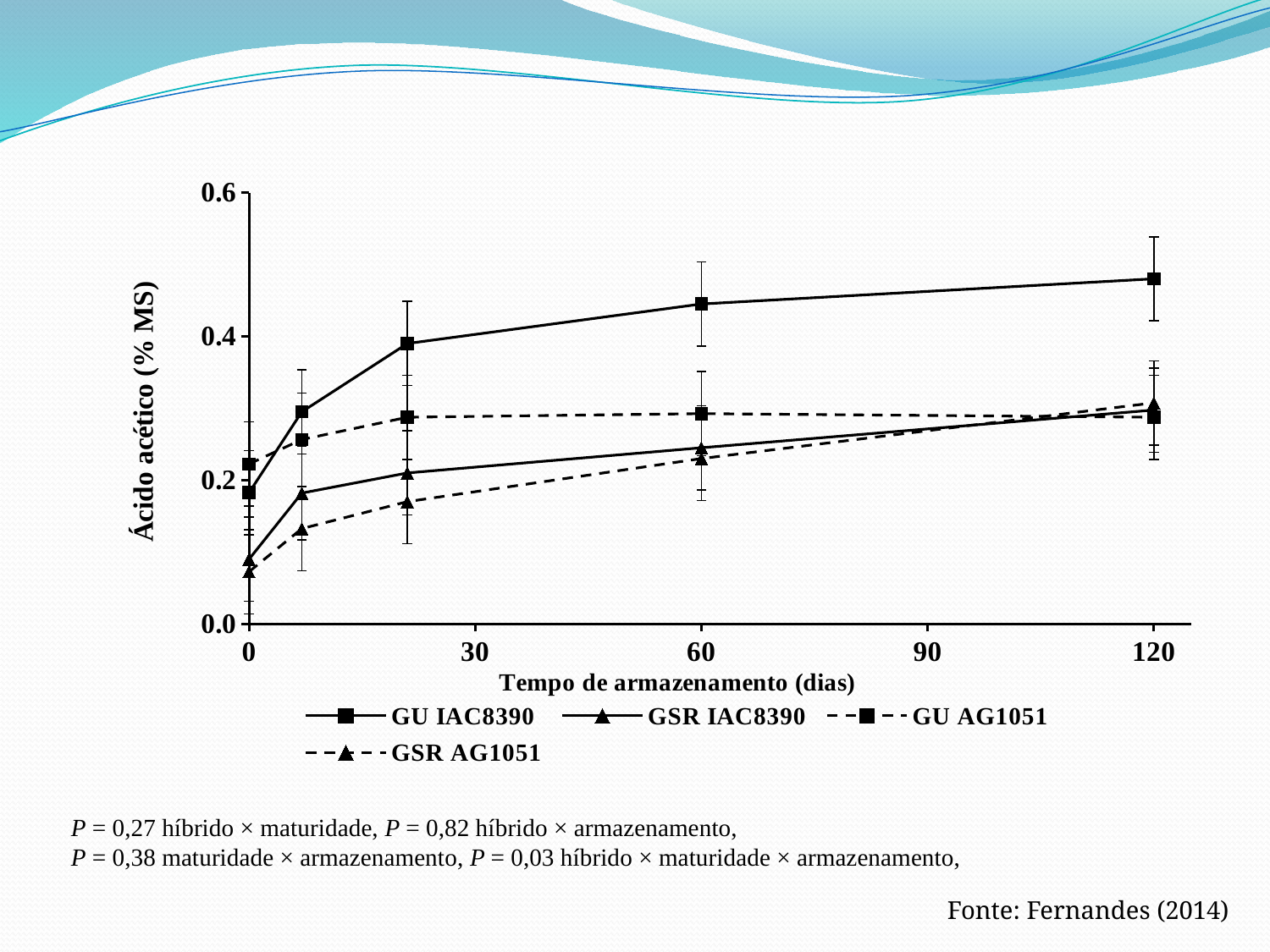
At 60 days, which is larger: GU IAC8390 or GSR IAC8390? GU IAC8390 What is the label of the y axis? Ácido acético (% MS) What kind of chart is shown on the slide? line chart Is the value for GU AG1051 at 60 days greater or less than 0.4? less Which series has the highest value at 120 days? GU IAC8390 What is the label of the x axis? Tempo de armazenamento (dias) Does the GU IAC8390 series rise or fall as storage time increases? rise Is the value for GU IAC8390 at 120 days greater or less than 0.4? greater How many data points are plotted for the GU IAC8390 series? 5 Is the value for GSR AG1051 at 0 days greater or less than 0.2? less How many series does the legend list? 4